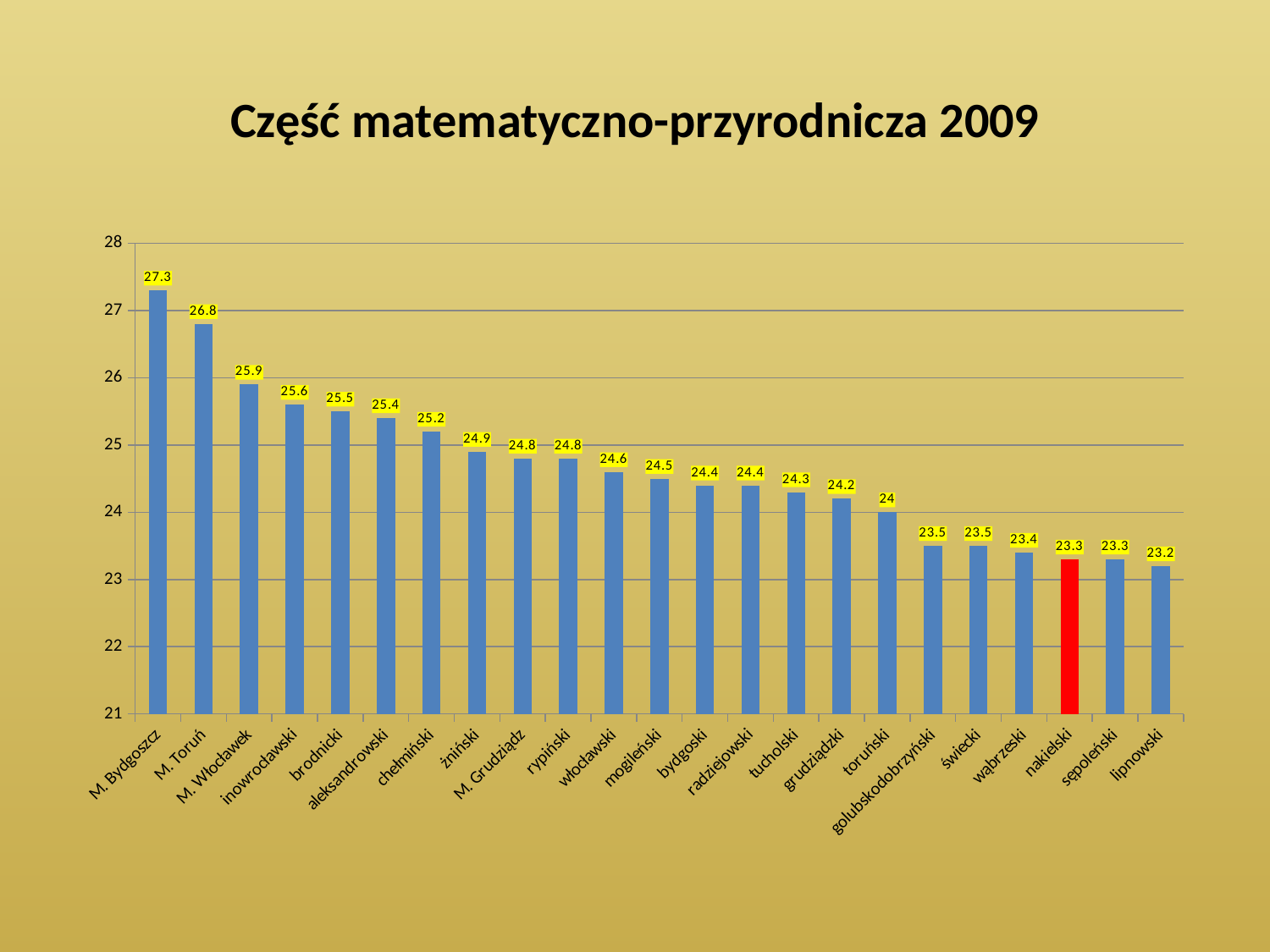
What is the value for M. Bydgoszcz? 27.3 What is the difference between the values for M. Bydgoszcz and M. Toruń? 0.5 Which is larger, the value for inowrocławski or the value for tucholski? inowrocławski Which bar is coloured red? nakielski Is the value for M. Włocławek greater or less than 25? greater How many categories are shown on the chart? 23 What is the value for nakielski? 23.3 What is the value for chełmiński? 25.2 Which category has the lowest value? lipnowski What is the value for toruński? 24 Which category has the highest value? M. Bydgoszcz What kind of chart is shown on the slide? bar chart